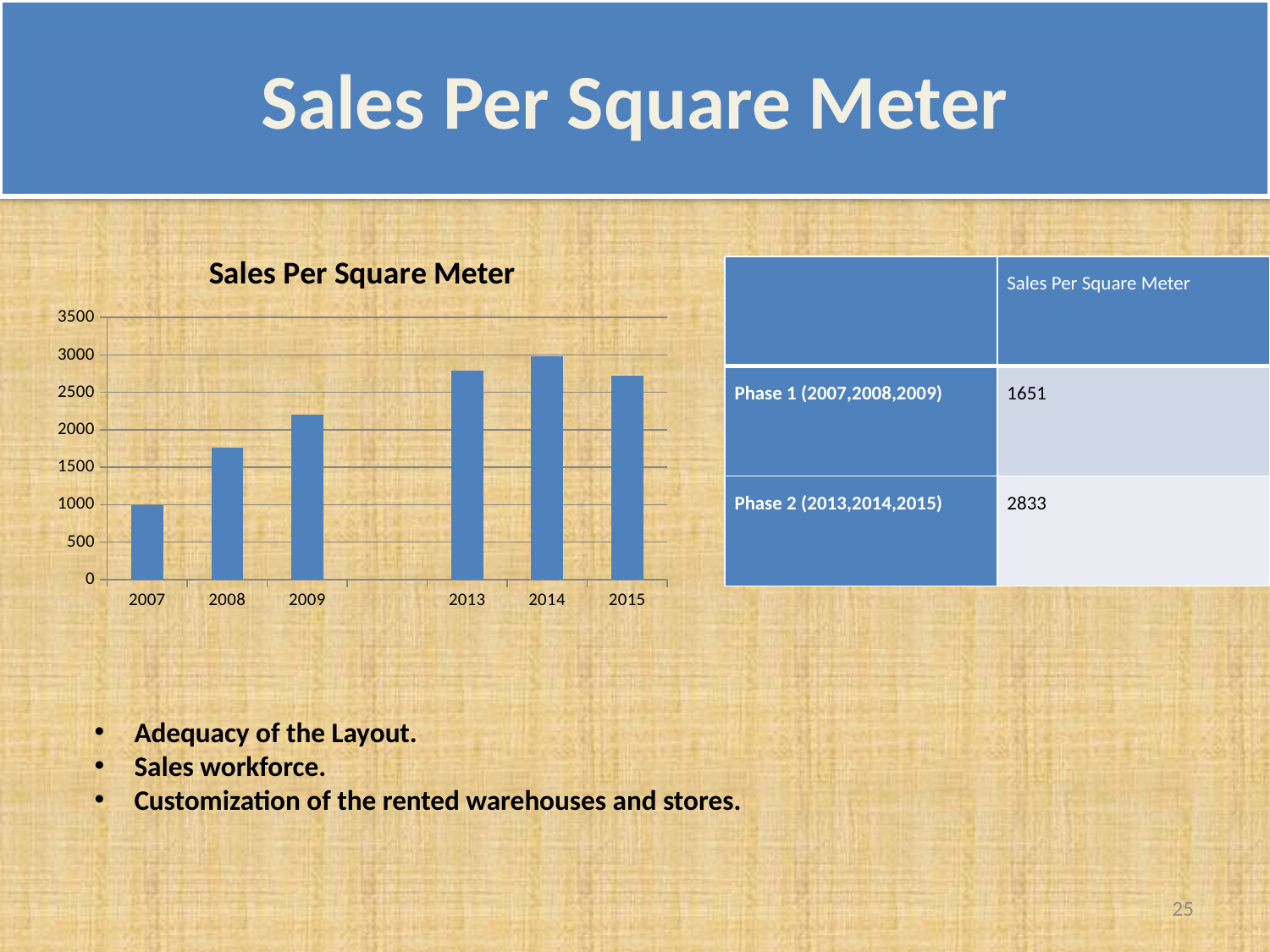
Which year has the larger value, 2008 or 2009? 2009 Is the value for 2007 greater or less than 1500? less Which year has the highest sales per square meter in the chart? 2014 How many years are shown on the x axis of the chart? 6 Do the values rise or fall from 2007 to 2009? rise What is the title of the chart? Sales Per Square Meter Which year has the lowest sales per square meter in the chart? 2007 Is the value for 2008 greater or less than 1500? greater What kind of chart is shown on the slide? bar chart Is the value for 2013 greater or less than 2500? greater